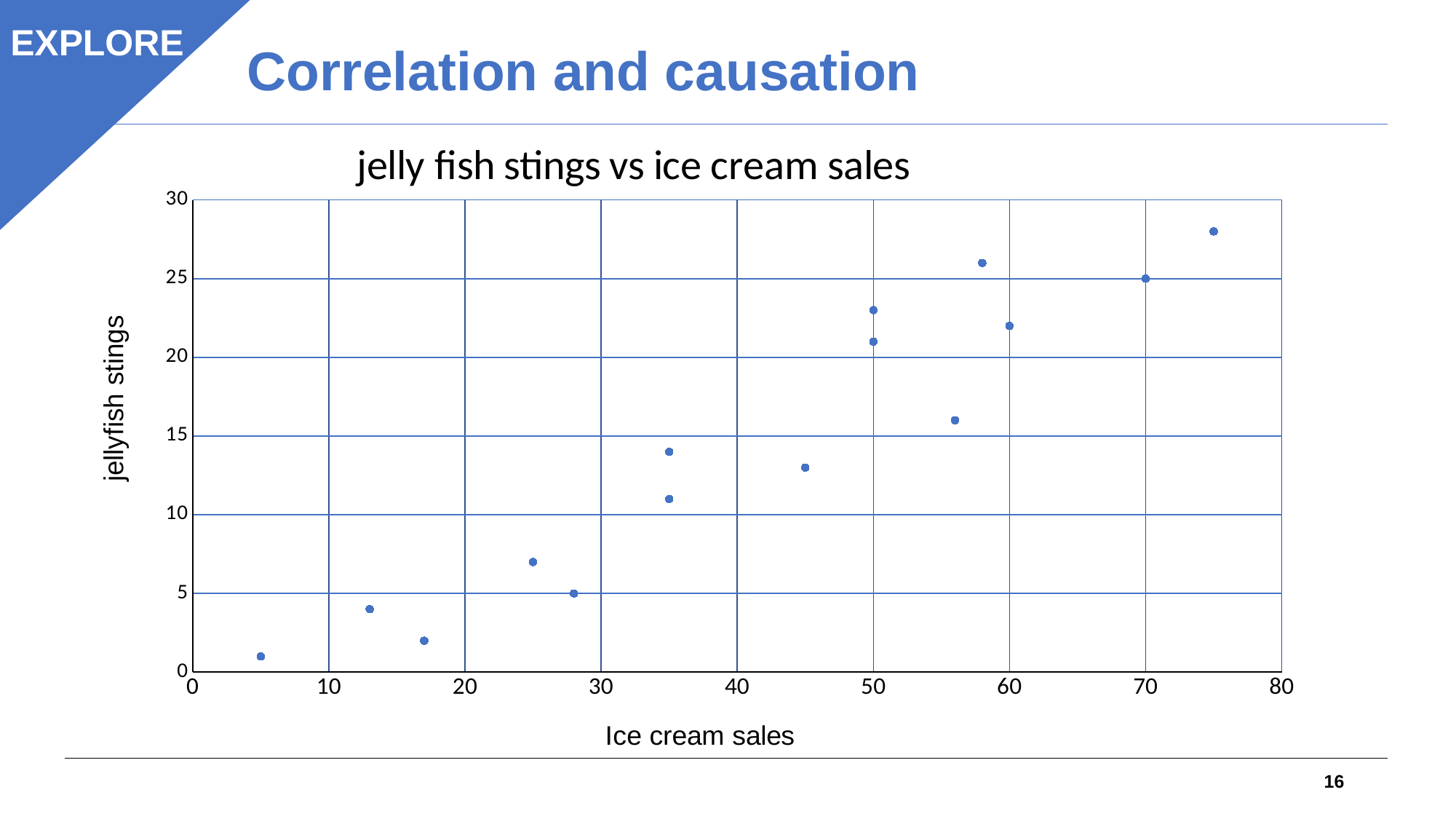
Is the jellyfish stings value for the point at ice cream sales of 45 greater or less than 10? greater Is the jellyfish stings value for the point at ice cream sales of 75 greater or less than 25? greater What is the label of the vertical axis? jellyfish stings What kind of chart is shown on the slide? scatter plot Which has more jellyfish stings: the point at ice cream sales of 58 or the point at ice cream sales of 56? 58 What is the title of the chart? jelly fish stings vs ice cream sales Is the jellyfish stings value for the point at ice cream sales of 5 greater or less than 5? less Do jellyfish stings generally rise or fall as ice cream sales increase? rise What is the jellyfish stings value for the point at ice cream sales of 70? 25 How many data points are plotted on the chart? 15